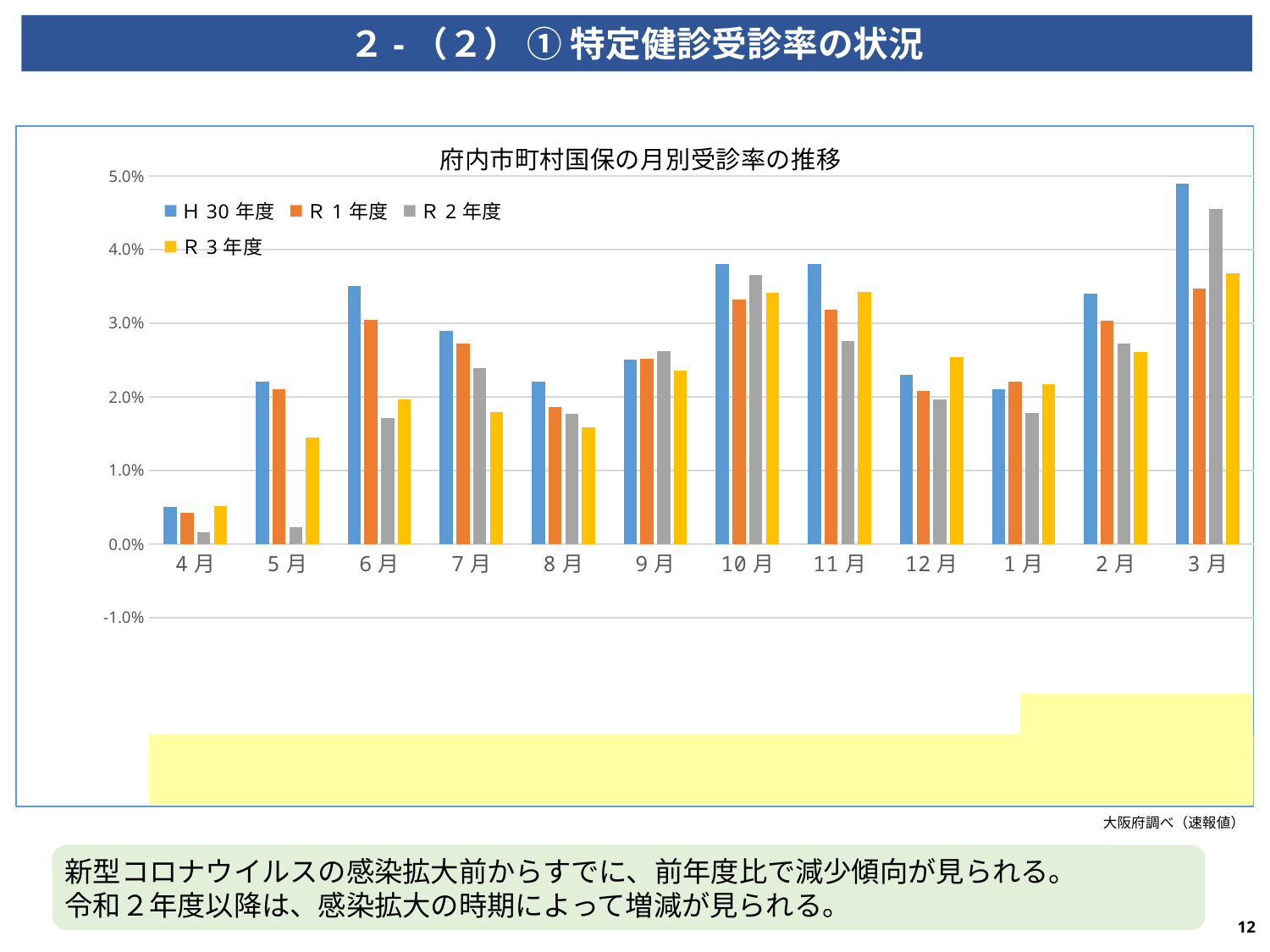
Is the value for R３年度 in 12月 greater or less than 2.0%? greater Which series is shown in yellow in the legend? R３年度 Is the value for H30年度 in 6月 greater or less than 3.0%? greater How many months are shown on the x axis? 12 Is the value for R２年度 in 5月 greater or less than 1.0%? less How many series does the legend list? 4 In which month is the H30年度 value highest? 3月 What kind of chart is shown on the slide? bar chart Which series has the lowest value in 5月? R２年度 In 11月, which is larger: the H30年度 value or the R２年度 value? H30年度 What is the title of the chart? 府内市町村国保の月別受診率の推移